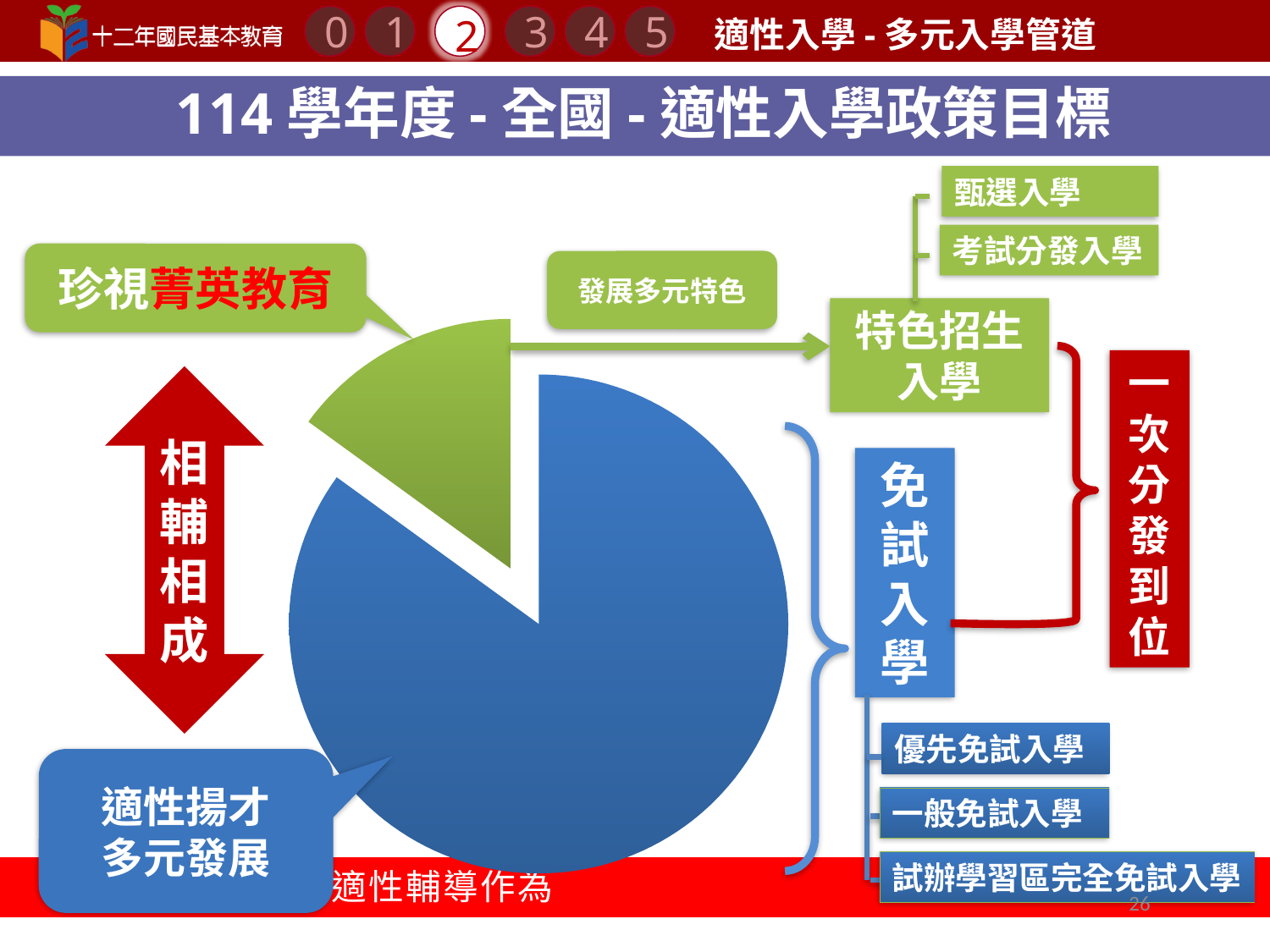
What colour is the 免試入學 slice of the pie chart? blue Which slice of the pie chart is the largest? 免試入學 How many slices does the pie chart have? 2 Which slice of the pie chart is the smallest? 特色招生入學 What colour is the 特色招生入學 slice of the pie chart? green Which is larger in the pie chart, the 免試入學 slice or the 特色招生入學 slice? 免試入學 What kind of chart is shown on the slide? pie chart